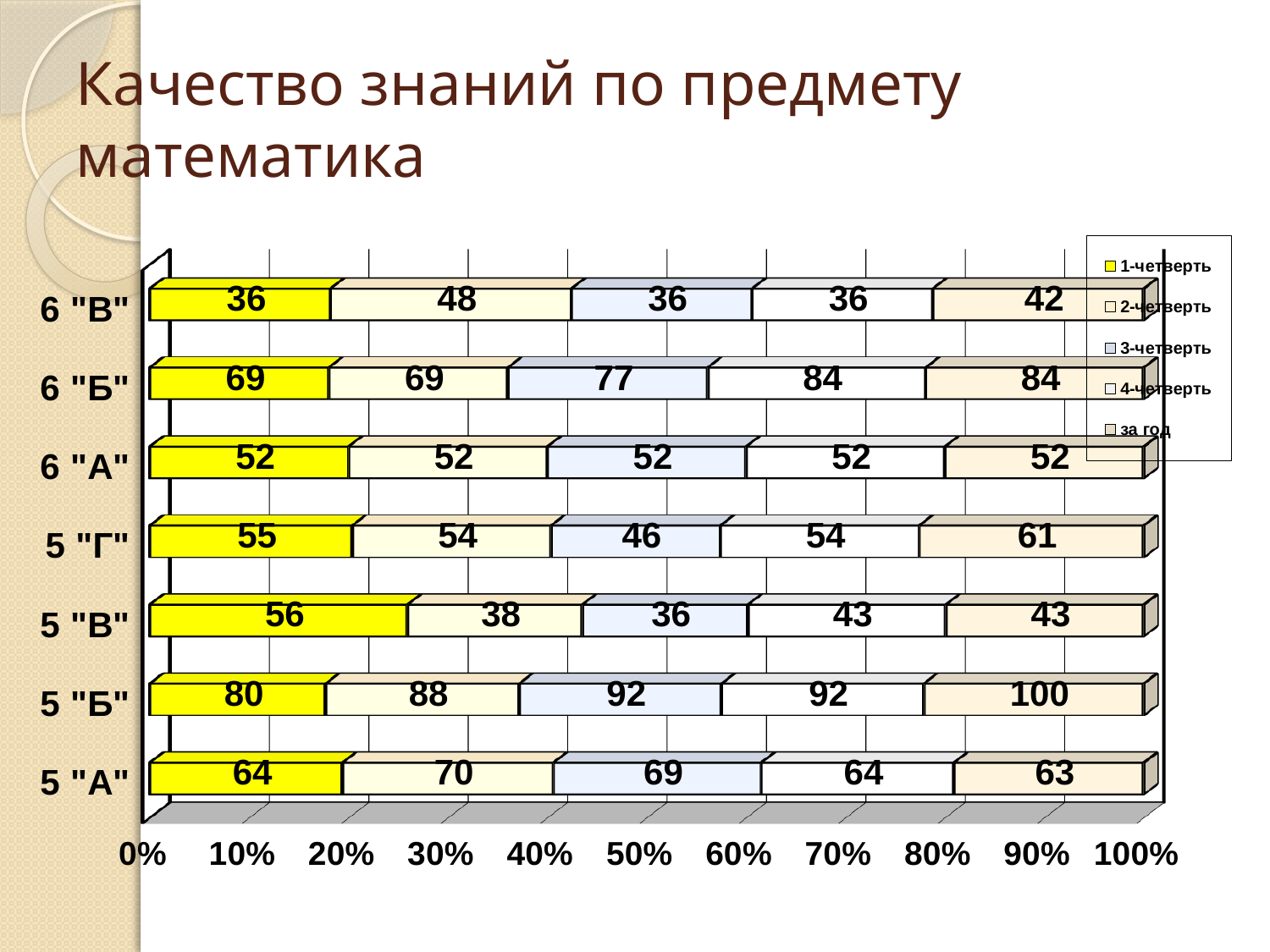
What is the value for за год for class 6 "В"? 42 What is the value for 1-четверть for class 5 "Б"? 80 What is the value for 3-четверть for class 6 "Б"? 77 What is the value for 4-четверть for class 5 "В"? 43 Which class has the lowest value for 1-четверть? 6 "В" What kind of chart is shown on the slide? Bar chart What is the first entry in the chart's legend? 1-четверть Which class has the highest value for за год? 5 "Б" Which class has the larger 2-четверть value, 5 "А" or 5 "Г"? 5 "А" What is the difference between the 4-четверть values for 6 "Б" and 6 "В"? 48 How many classes are shown on the chart? 7 How many series does the legend list? 5